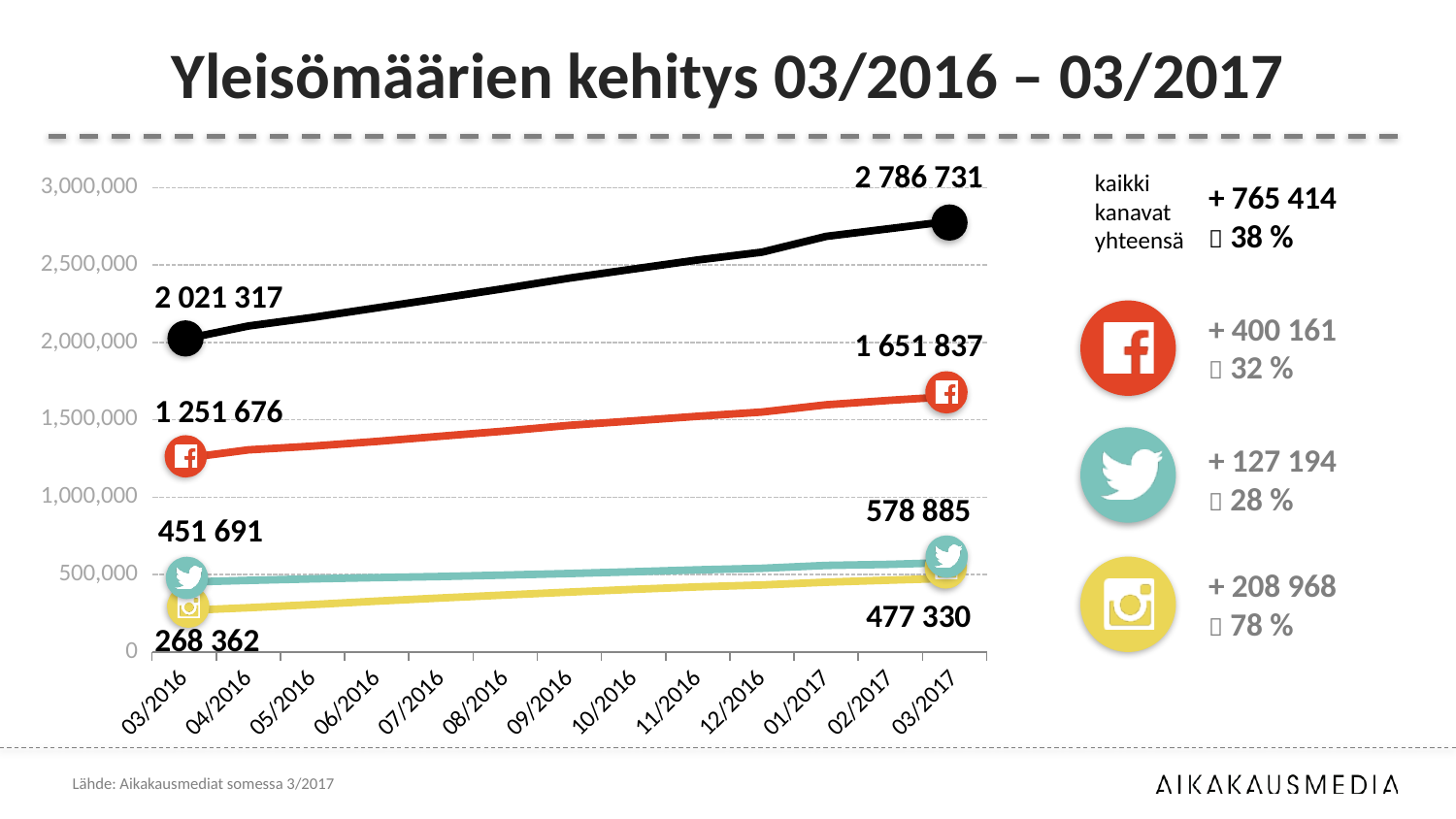
What is the Facebook value at 03/2016? 1 251 676 What is the Instagram value at 03/2016? 268 362 What is the value of the black (total) line at 03/2017? 2 786 731 What type of chart is shown on the slide? line chart Which channel has the lowest value at 03/2017: Facebook, Twitter or Instagram? Instagram How many months are shown on the x axis? 13 What is the value of the black (total) line at 03/2016? 2 021 317 Does the black (total) line rise or fall from 03/2016 to 03/2017? rise What is the Twitter value at 03/2017? 578 885 By how much did the Instagram value increase from 03/2016 to 03/2017? 208 968 Which is larger at 03/2016, the Twitter value or the Instagram value? Twitter By how much did the Facebook value increase from 03/2016 to 03/2017? 400 161